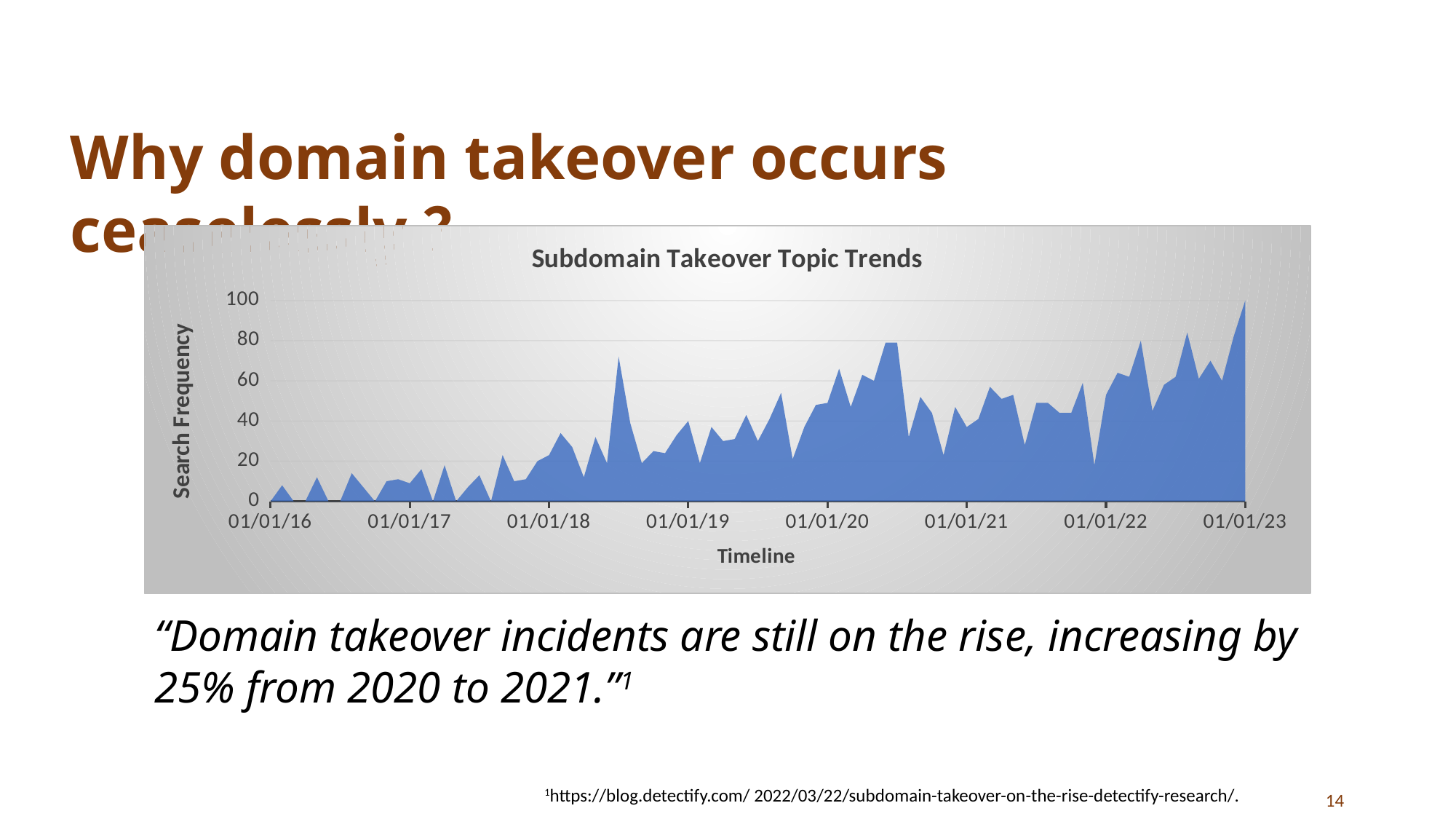
What kind of chart is shown on the slide? area chart Is the value at 01/01/21 greater or less than 80? less Which is larger, the value at 01/01/16 or the value at 01/01/23? 01/01/23 What is the title of the chart? Subdomain Takeover Topic Trends Is the value at 01/01/23 greater or less than 80? greater What is the highest value shown on the vertical axis of the chart? 100 How many date ticks are labelled on the x axis of the chart? 8 Is the value at 01/01/20 greater or less than 20? greater What is the label of the vertical axis of the chart? Search Frequency At which x-axis tick does the chart reach its highest value? 01/01/23 Overall, do the values in the chart rise or fall from 01/01/16 to 01/01/23? rise